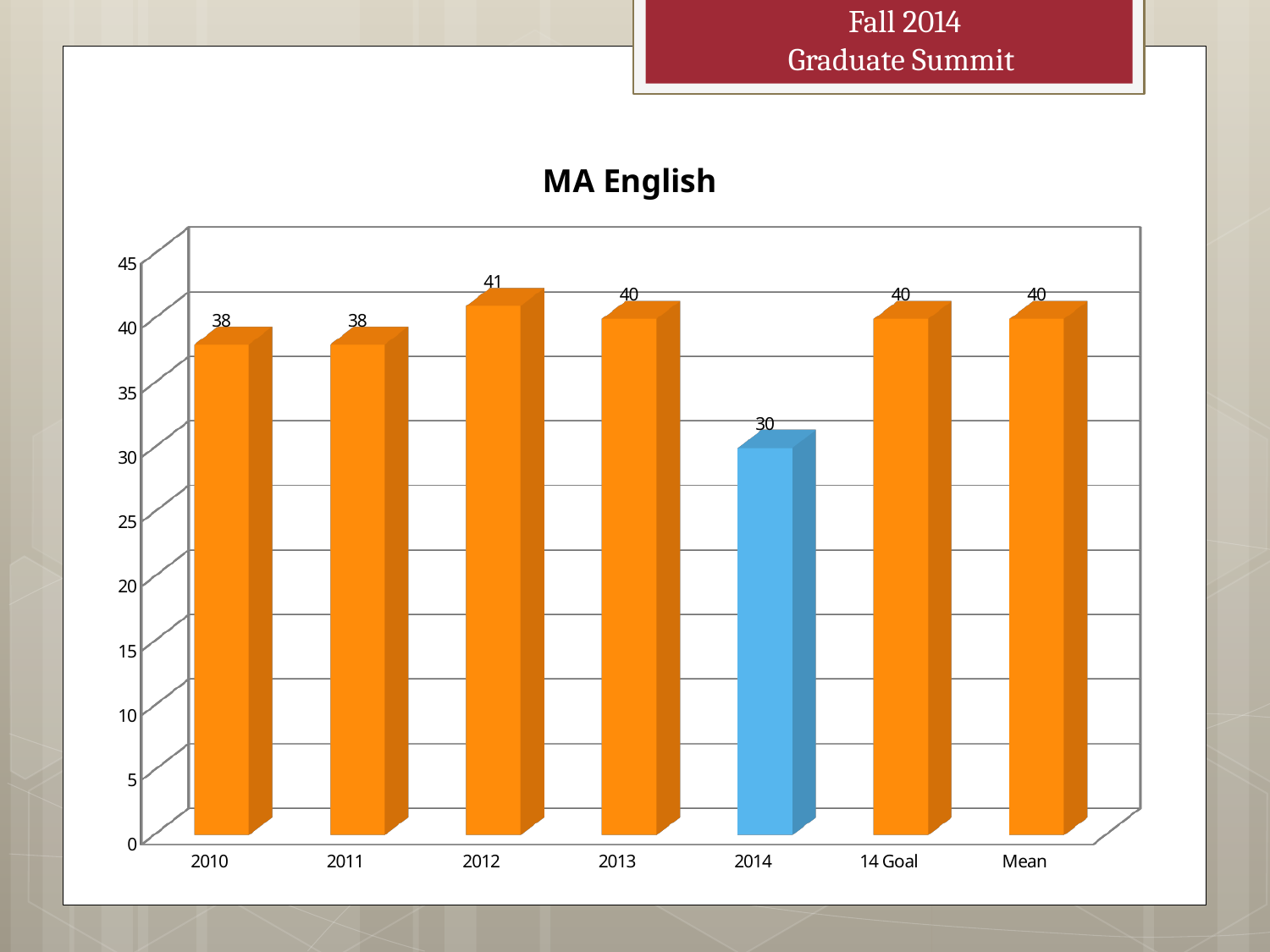
Which category has the highest value in the MA English chart? 2012 Is the value for 2011 in the MA English chart greater or less than 35? greater Which is larger in the MA English chart, the value for 2013 or the value for 2014? 2013 Which category has the lowest value in the MA English chart? 2014 Which bar in the MA English chart is coloured blue rather than orange? 2014 What is the value for 2012 in the MA English chart? 41 What is the difference between the 14 Goal value and the 2014 value in the MA English chart? 10 What is the value for 14 Goal in the MA English chart? 40 What is the difference between the 2012 value and the 2010 value in the MA English chart? 3 What is the value for 2014 in the MA English chart? 30 How many categories are shown on the x axis of the MA English chart? 7 What kind of chart is the MA English chart? bar chart